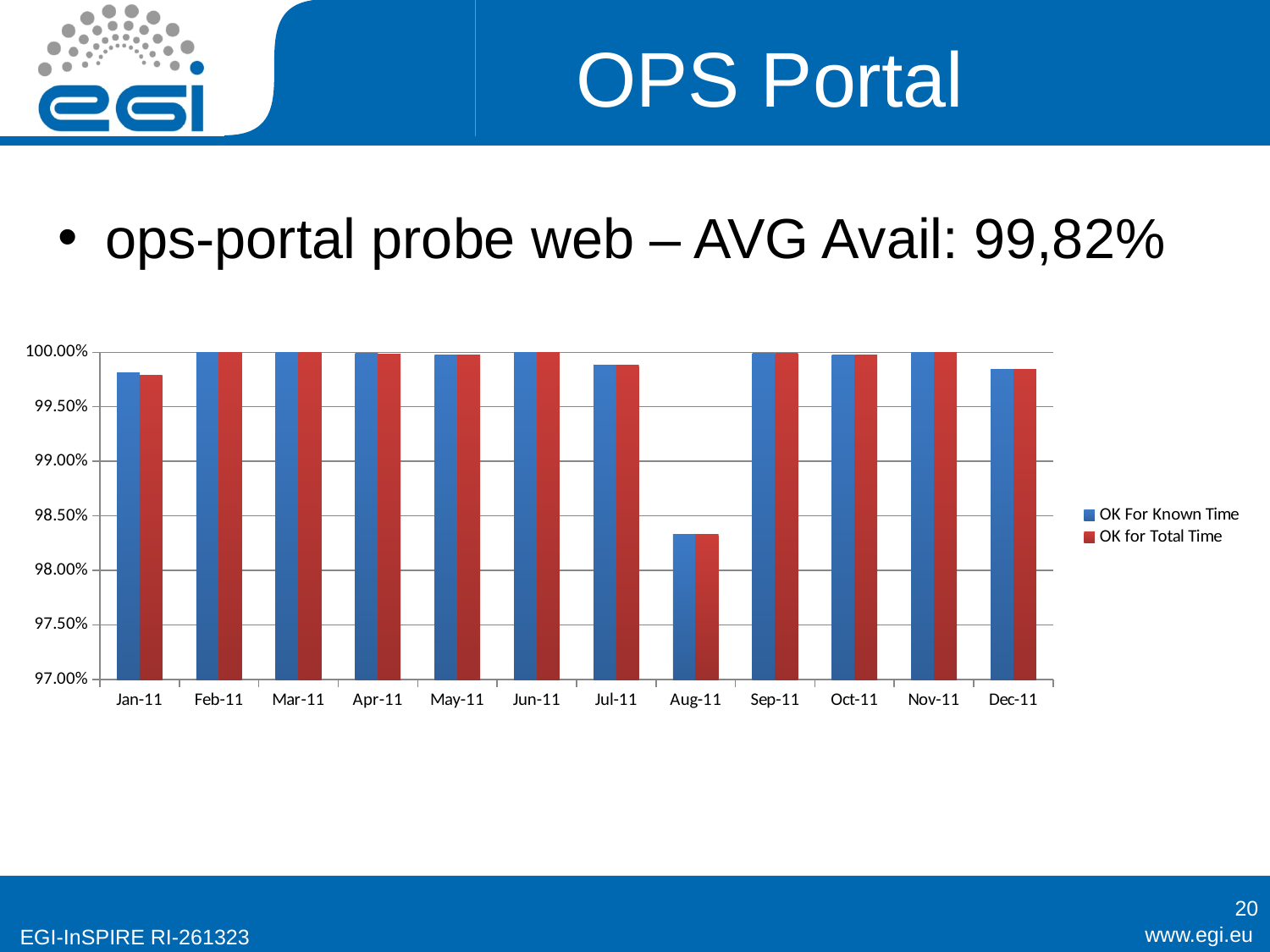
What are the two series named in the chart's legend? OK For Known Time and OK for Total Time Which month has the lowest value for OK for Total Time? Aug-11 What kind of chart is shown on the slide? bar chart Is the OK for Total Time value for Aug-11 greater or less than 98.00%? greater Is the OK For Known Time value for Aug-11 greater or less than 98.50%? less What colour are the bars for the OK for Total Time series? red Is the OK For Known Time value for Jan-11 greater or less than 99.50%? greater Which is larger, the OK For Known Time value for Aug-11 or for Sep-11? Sep-11 How many series does the chart's legend list? 2 Which month has the lowest value for OK For Known Time? Aug-11 How many months are shown on the x axis of the chart? 12